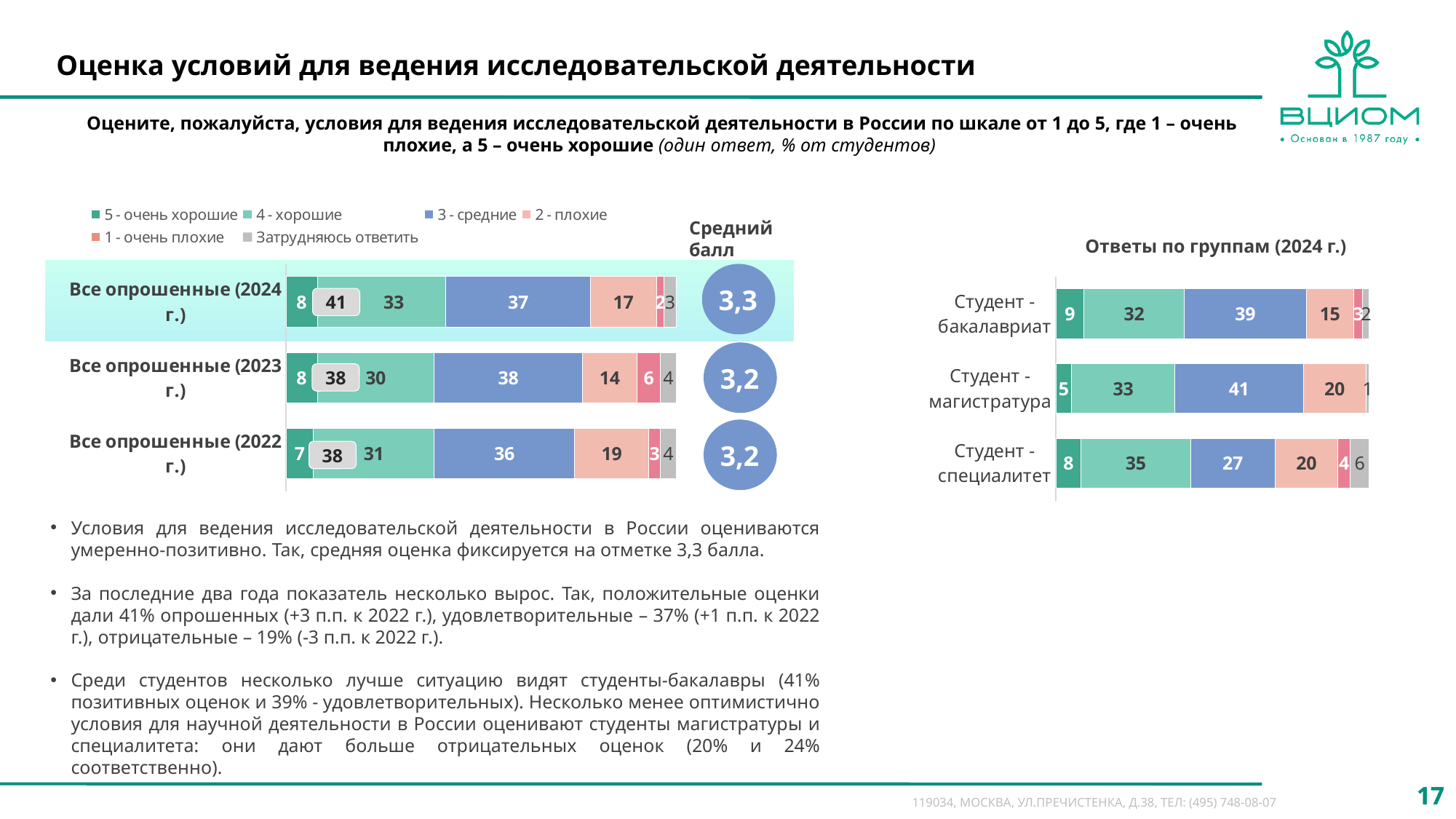
How many groups are shown on the chart "Ответы по группам (2024 г.)"? 3 What type of chart is used on the left side of the slide? Stacked bar chart On the chart "Ответы по группам (2024 г.)", what percentage of "Студент - магистратура" gave the rating "3 - средние"? 41 On the chart "Ответы по группам (2024 г.)", is the "5 - очень хорошие" share larger for "Студент - бакалавриат" or "Студент - магистратура"? Студент - бакалавриат On the chart "Ответы по группам (2024 г.)", which group has the highest share of "4 - хорошие" ratings? Студент - специалитет How many series does the legend of the left chart list? 6 On the left chart, what is the difference between the "4 - хорошие" share in 2024 and in 2023? 3 On the left chart, which year has the highest share of "2 - плохие" ratings among all respondents? 2022 г. On the left chart, what percentage of all respondents in 2024 gave the rating "3 - средние"? 37 On the chart "Ответы по группам (2024 г.)", which group has the lowest share of "3 - средние" ratings? Студент - специалитет On the left chart, what is the average score (Средний балл) for all respondents in 2024? 3,3 On the left chart, what percentage of all respondents in 2023 gave the rating "1 - очень плохие"? 6